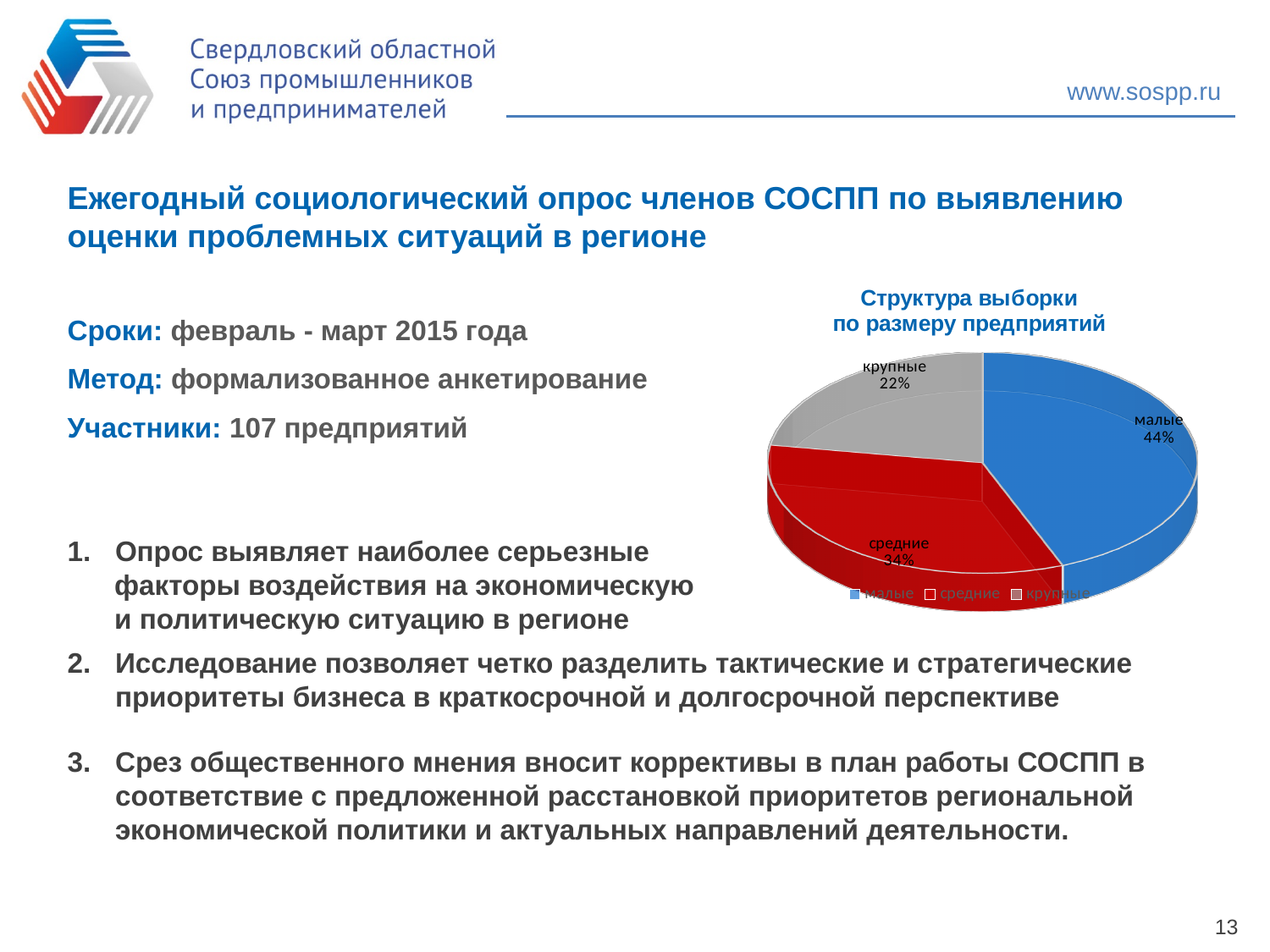
Which category has the largest share of the pie? малые What kind of chart is shown on the slide? pie chart Which category has the smallest share of the pie? крупные How many entries does the legend list? 3 What is the title of the chart? Структура выборки по размеру предприятий Which slice is larger, 'средние' or 'крупные'? средние What share of the pie does the 'крупные' slice represent? 22% What is the difference in percentage points between the 'малые' and 'крупные' slices? 22 What colour is the 'средние' slice? red How many slices does the pie chart have? 3 What share of the pie does the 'средние' slice represent? 34% What share of the pie does the 'малые' slice represent? 44%